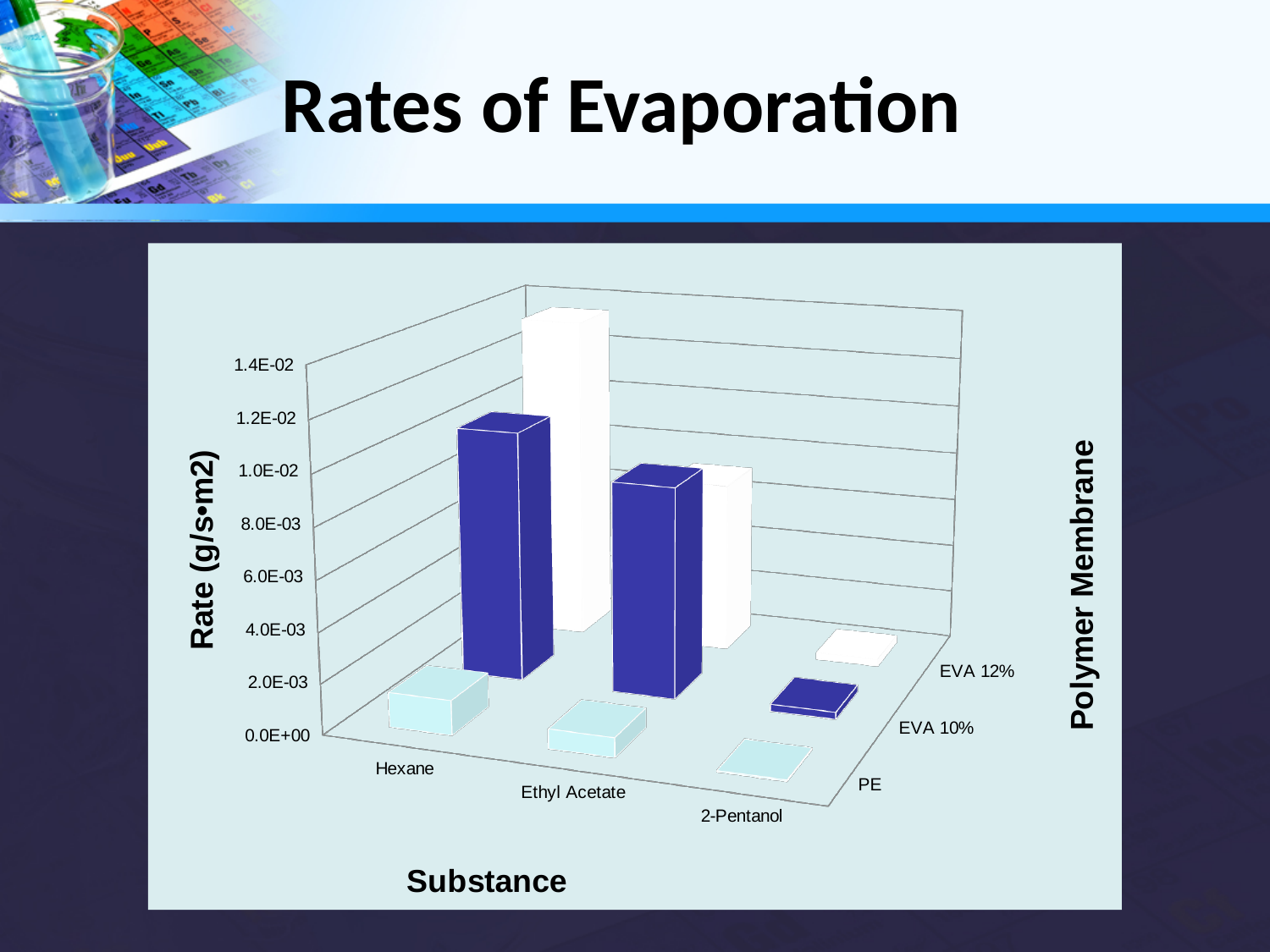
With the EVA 10% membrane, which has the higher evaporation rate, Hexane or Ethyl Acetate? Hexane Is the evaporation rate of Ethyl Acetate with the EVA 10% membrane greater or less than 4.0E-03? greater Is the evaporation rate of 2-Pentanol with the PE membrane greater or less than 2.0E-03? less What is the title of the chart's vertical axis? Rate (g/s•m2) Which substance has the lowest evaporation rate with the EVA 10% membrane? 2-Pentanol What kind of chart is shown on the slide? bar chart How many substances are shown along the Substance axis? 3 Which substance has the highest evaporation rate with the EVA 12% membrane? Hexane Is the evaporation rate of Hexane with the EVA 12% membrane greater or less than 1.2E-02? greater What is the title of the chart's depth axis listing PE, EVA 10% and EVA 12%? Polymer Membrane For the EVA 12% membrane, do the evaporation rates rise or fall going from Hexane to 2-Pentanol? fall How many polymer membranes are shown on the chart? 3